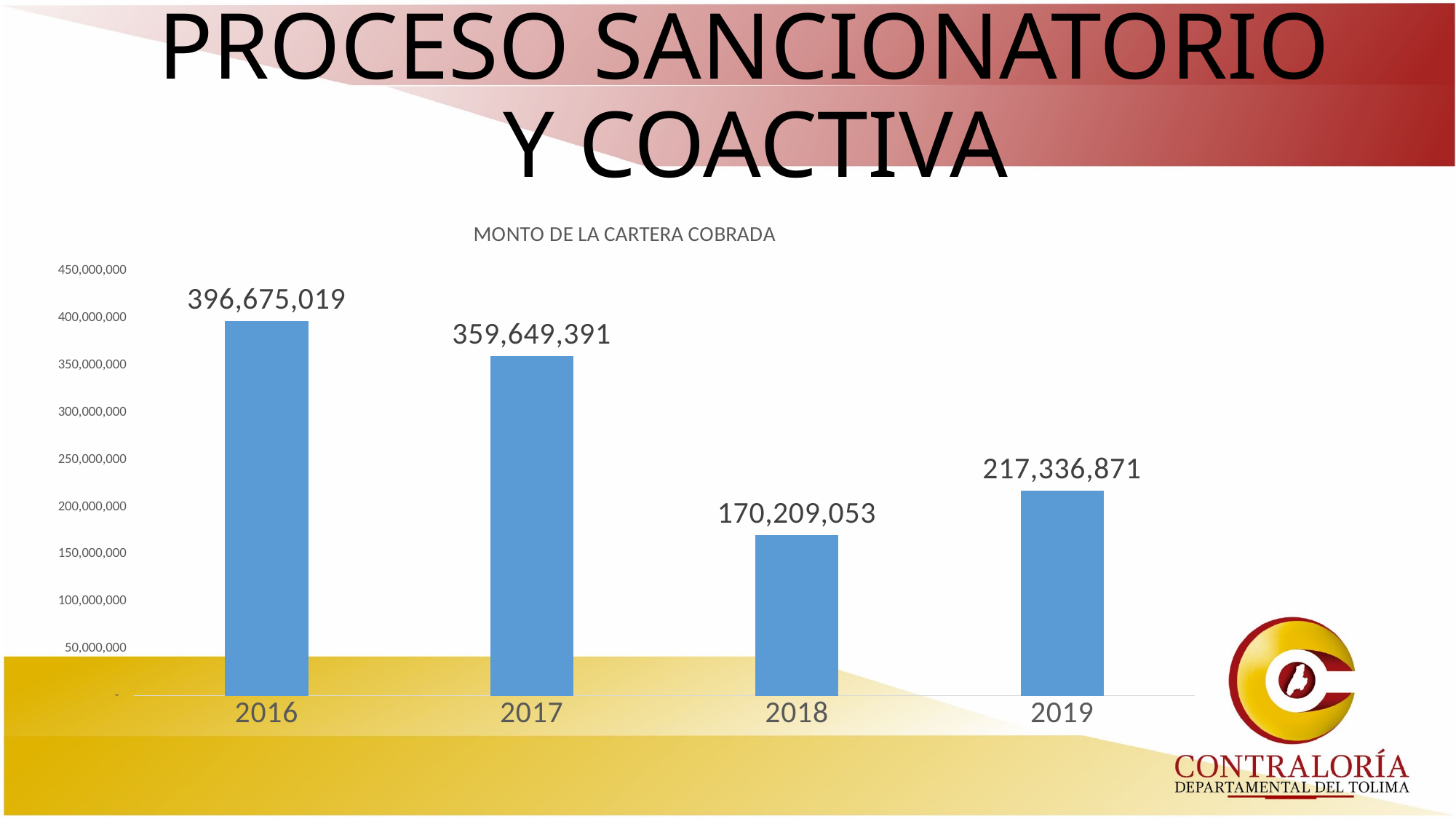
What is the value for 2016? 396,675,019 What is the difference between the values for 2016 and 2017? 37,025,628 What is the value for 2019? 217,336,871 What is the value for 2018? 170,209,053 What is the difference between the values for 2019 and 2018? 47,127,818 What is the value for 2017? 359,649,391 Which year has the lowest value? 2018 What kind of chart is this? Bar chart What is the title of the chart? MONTO DE LA CARTERA COBRADA Which year has the highest value? 2016 How many years are shown on the x axis? 4 Which is larger, the value for 2018 or the value for 2019? 2019